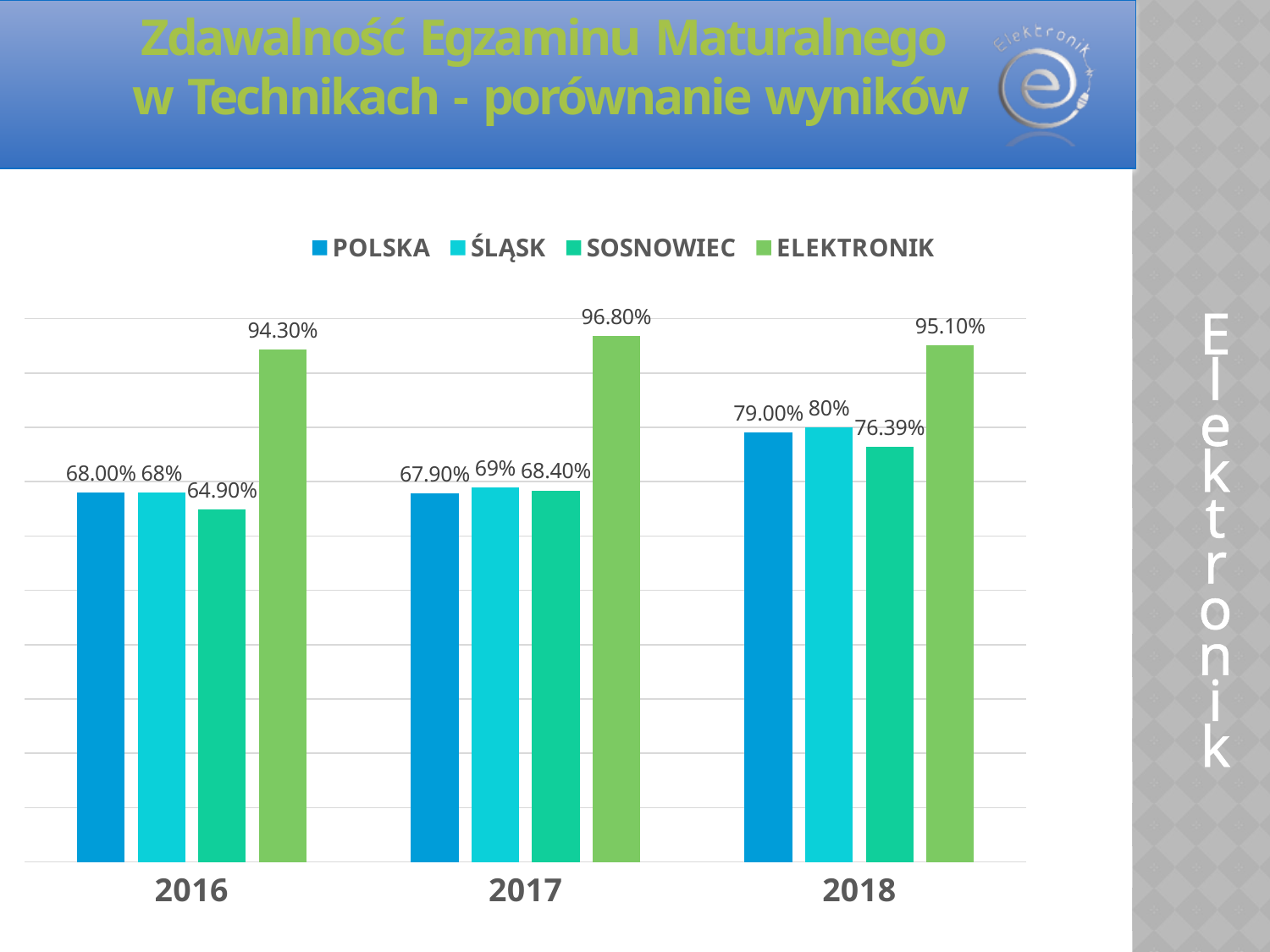
What is the value for SOSNOWIEC in 2016? 64.90% Does the POLSKA value rise or fall from 2017 to 2018? Rise What kind of chart is shown on the slide? Bar chart How many years are shown on the x axis? 3 Which series has the lowest value in 2016? SOSNOWIEC What is the value for ŚLĄSK in 2017? 69% What is the value for POLSKA in 2018? 79.00% Which is larger in 2018: the value for ŚLĄSK or the value for SOSNOWIEC? ŚLĄSK What is the value for ELEKTRONIK in 2017? 96.80% How many series does the legend list? 4 In which year is the ELEKTRONIK value highest? 2017 What is the difference between the ELEKTRONIK and POLSKA values in 2018? 16.10%